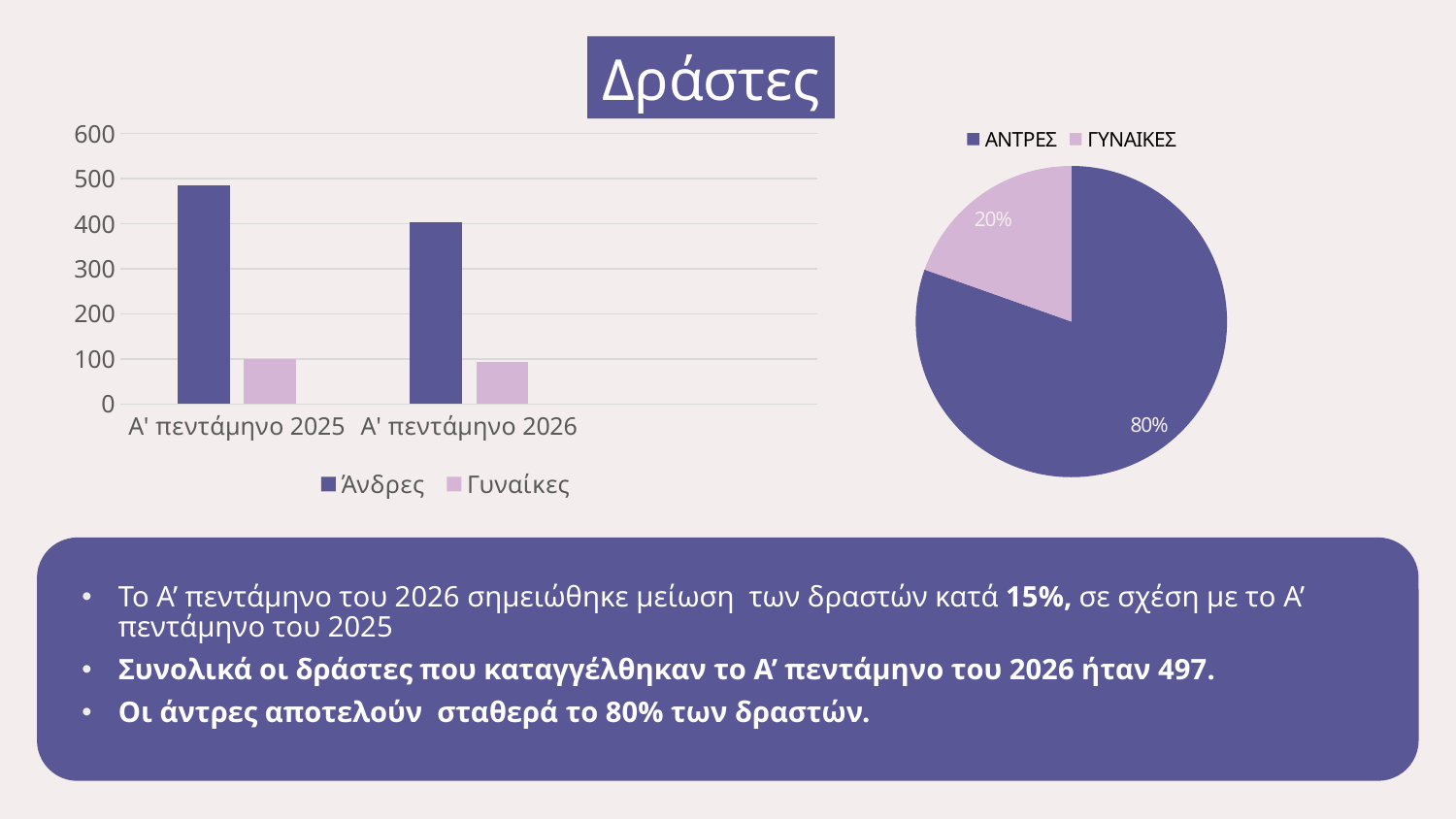
In the bar chart on the left, is the value for Άνδρες in Α' πεντάμηνο 2026 greater or less than 500? less What kind of chart is the chart on the left of the slide? bar chart In the bar chart on the left, how many series does the legend list? 2 In the bar chart on the left, is the value for Γυναίκες in Α' πεντάμηνο 2026 greater or less than 200? less In the pie chart on the right, what share does ΑΝΤΡΕΣ have? 80% In the pie chart on the right, what share does ΓΥΝΑΙΚΕΣ have? 20% In the pie chart on the right, which slice is the largest? ΑΝΤΡΕΣ In the bar chart on the left, which series has the higher value in Α' πεντάμηνο 2025, Άνδρες or Γυναίκες? Άνδρες What kind of chart is the chart on the right of the slide? pie chart In the bar chart on the left, is the value for Άνδρες in Α' πεντάμηνο 2025 greater or less than 400? greater In the bar chart on the left, does the value for Άνδρες rise or fall from Α' πεντάμηνο 2025 to Α' πεντάμηνο 2026? fall In the bar chart on the left, how many categories are shown on the x axis? 2